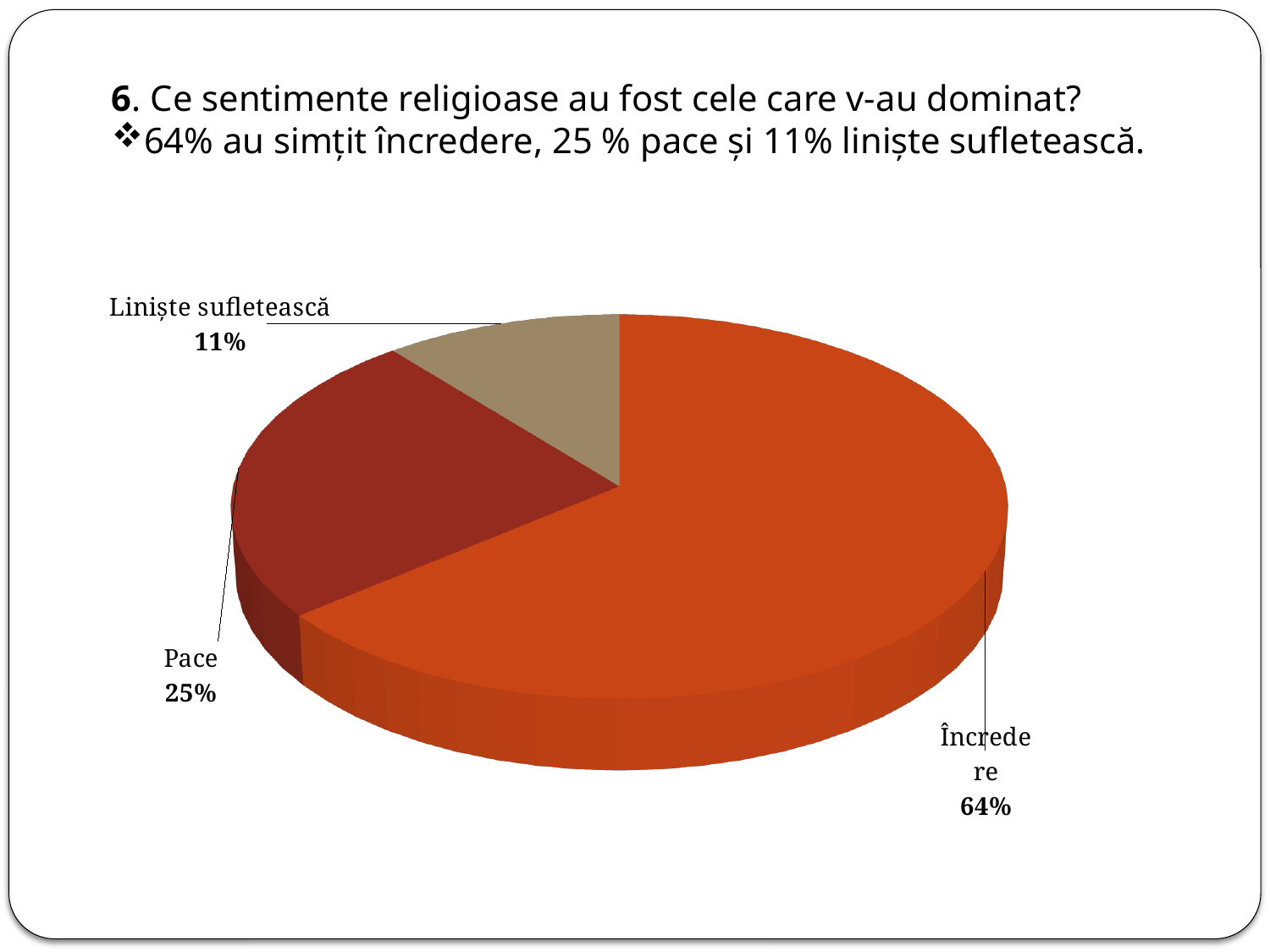
How many slices does the pie chart have? 3 Which is larger, the value for Pace or the value for Liniște sufletească? Pace Which category has the smallest share of the pie? Liniște sufletească Which category has the largest share of the pie? Încredere What is the difference between the values for Pace and Liniște sufletească? 14% What is the difference between the values for Încredere and Pace? 39% What kind of chart is shown on the slide? Pie chart What is the value for Încredere? 64% What colour is the Liniște sufletească slice? Beige/tan What is the value for Liniște sufletească? 11% What share of the pie does the Încredere slice represent? 64% What is the value for Pace? 25%